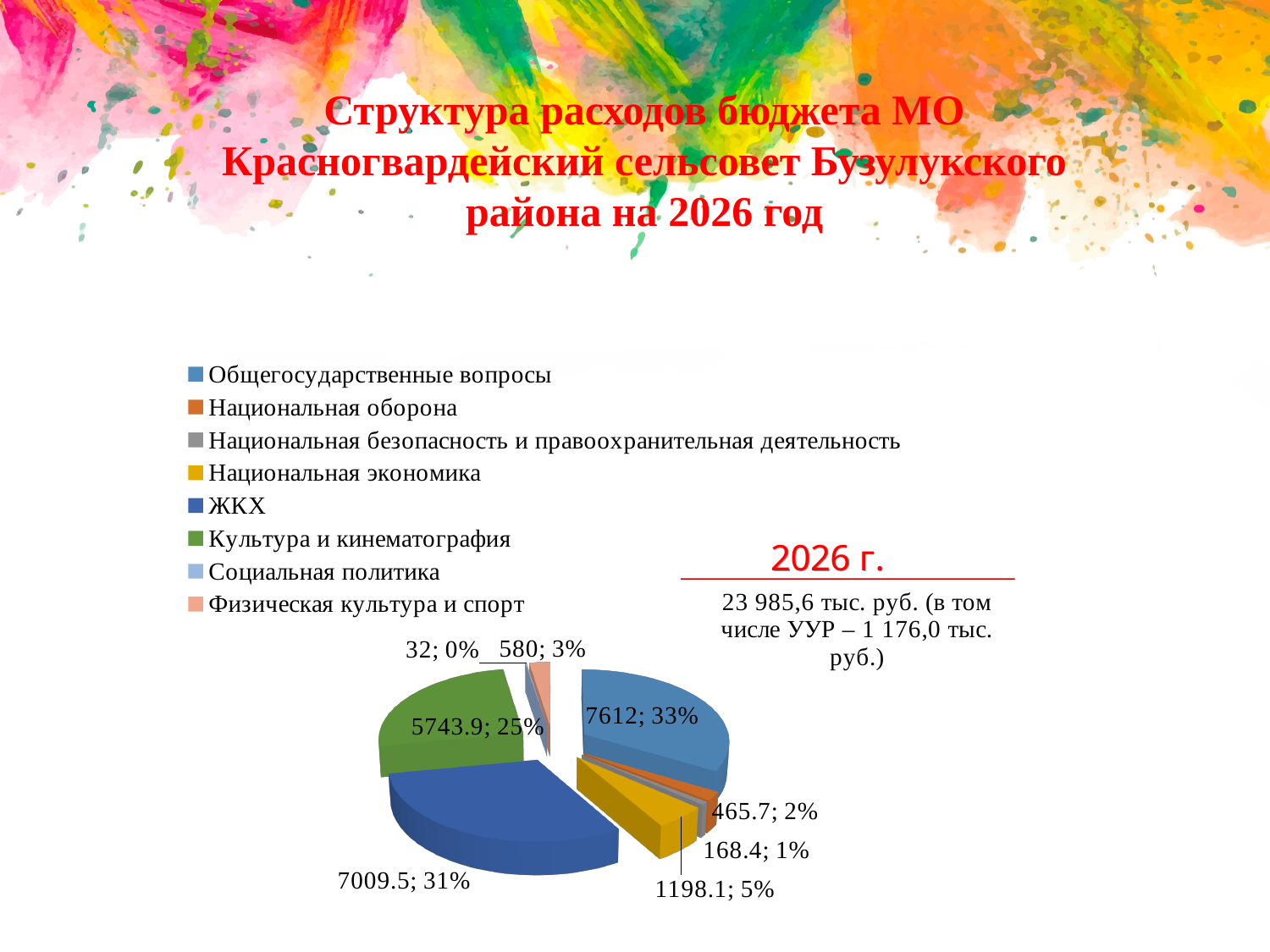
What year is shown in the label next to the pie chart? 2026 г. What is the difference between the values for Общегосударственные вопросы and ЖКХ? 602.5 What value is shown for Общегосударственные вопросы in the pie chart? 7612 What value is shown for Культура и кинематография? 5743.9 What type of chart is shown on the slide? pie chart What share of the pie does Национальная экономика represent? 5% Which category has the largest slice of the pie? Общегосударственные вопросы How many categories does the legend of the pie chart list? 8 Which category has the smallest slice of the pie? Социальная политика Which is larger, the value for Национальная оборона or the value for Национальная безопасность и правоохранительная деятельность? Национальная оборона What value is shown for Физическая культура и спорт? 580 What share of the pie does ЖКХ represent? 31%